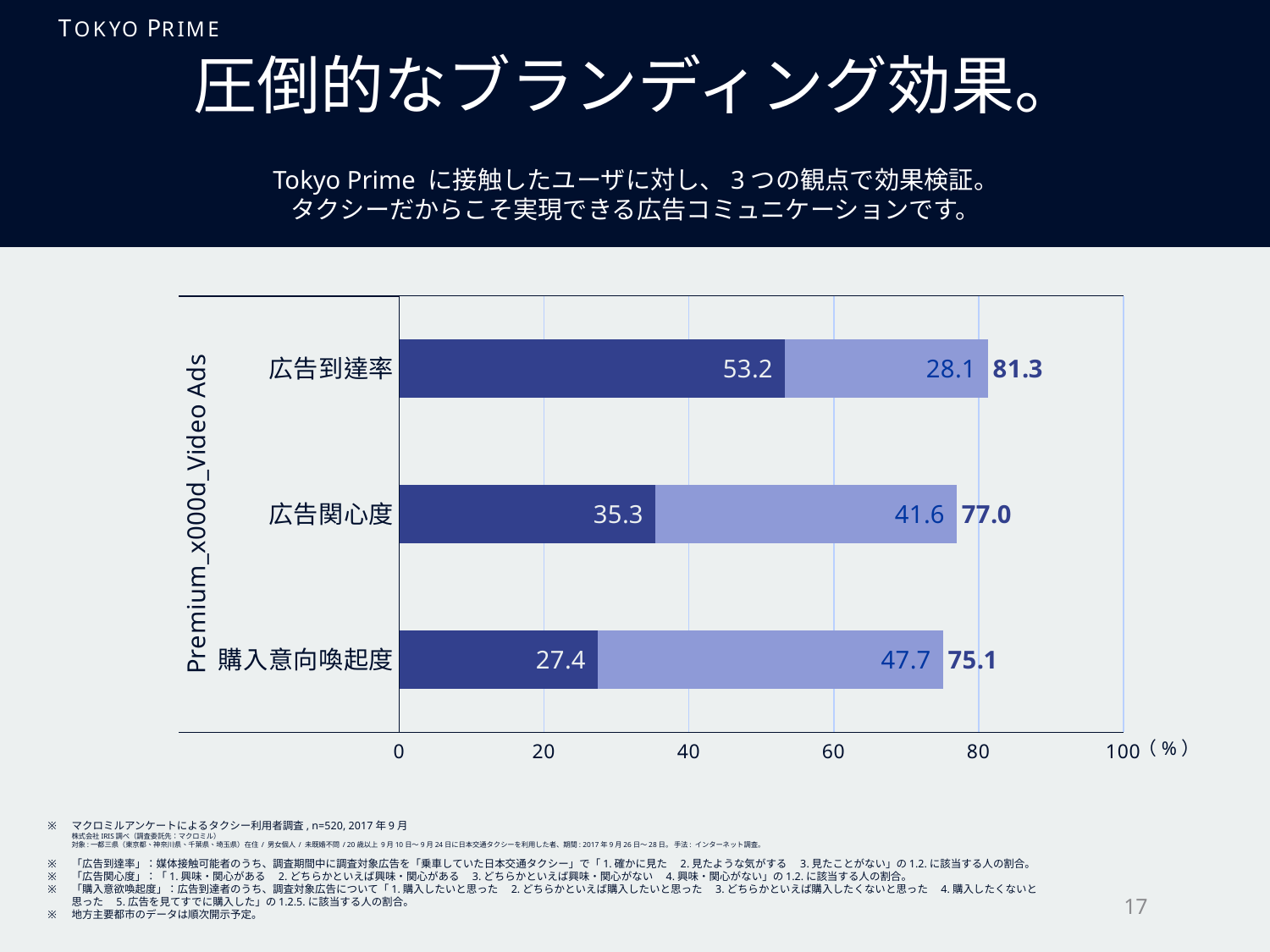
Which category has the highest total value? 広告到達率 What is the total value shown for 広告関心度? 77.0 What is the total value shown for 広告到達率? 81.3 What is the value of the dark blue segment for 広告関心度? 35.3 What is the difference between the total for 広告到達率 and the total for 購入意向喚起度? 6.2 Which is larger: the dark blue segment for 広告到達率 or the dark blue segment for 購入意向喚起度? 広告到達率 What is the value of the dark blue segment for 広告到達率? 53.2 What kind of chart is shown on the slide? stacked bar chart What is the value of the light blue segment for 購入意向喚起度? 47.7 What is the total value shown for 購入意向喚起度? 75.1 How many categories are plotted in the chart? 3 Which category has the lowest total value? 購入意向喚起度